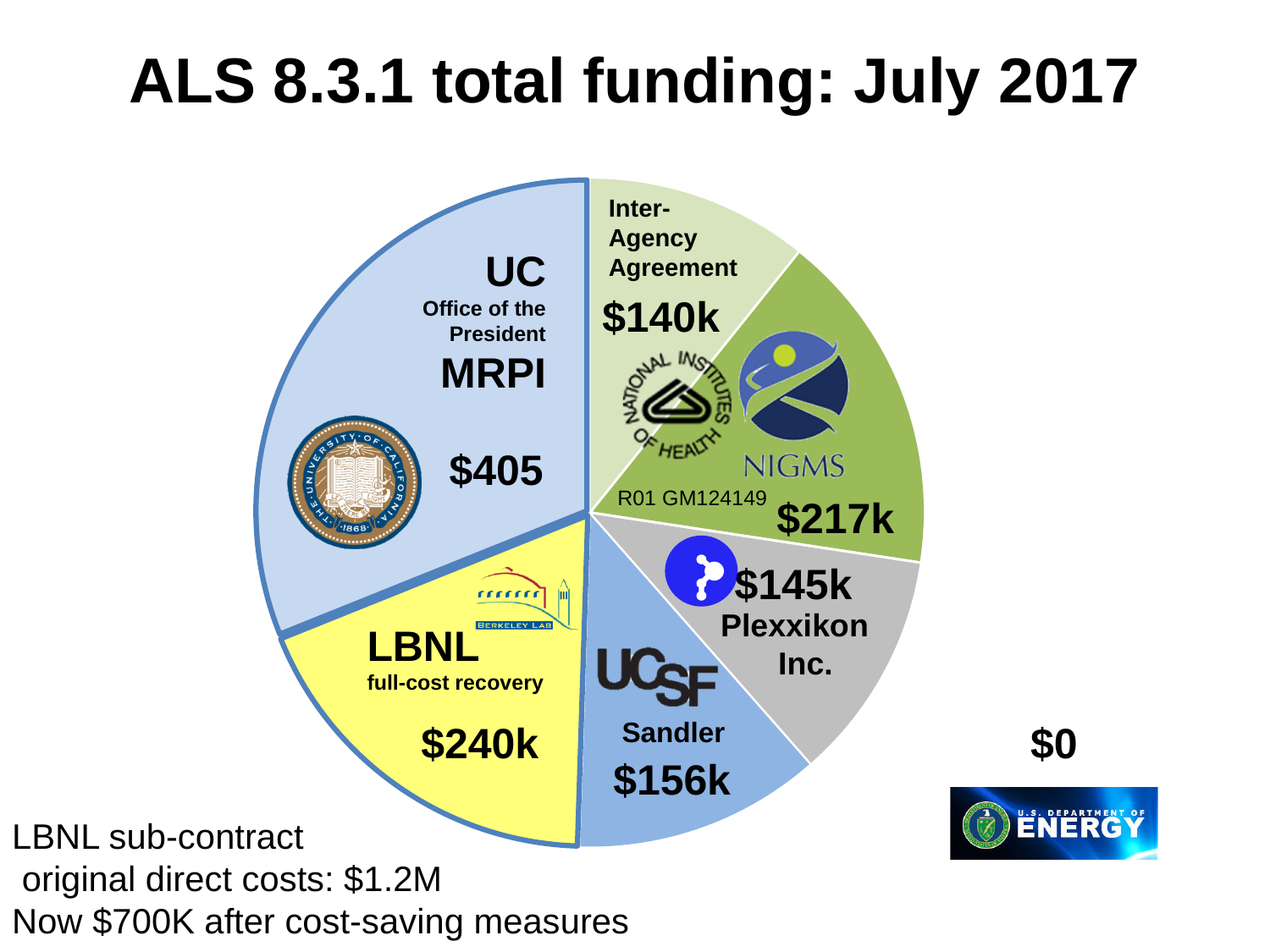
Which is larger, the UCSF Sandler funding or the Plexxikon Inc. funding? UCSF Sandler What is the funding value shown for the Plexxikon Inc. slice? $145k What is the funding value shown for the Inter-Agency Agreement slice? $140k What is the funding value shown for the NIGMS slice? $217k How many slices does the pie chart have? 6 What is the difference between the LBNL full-cost recovery funding and the Inter-Agency Agreement funding? $100k What is the funding value shown for the LBNL full-cost recovery slice? $240k What is the title of the slide's chart? ALS 8.3.1 total funding: July 2017 Which funding source has the largest slice of the pie? UC Office of the President MRPI What is the funding value shown for the UCSF Sandler slice? $156k Which funding source has the smallest slice of the pie? Inter-Agency Agreement What kind of chart is shown on the slide? pie chart